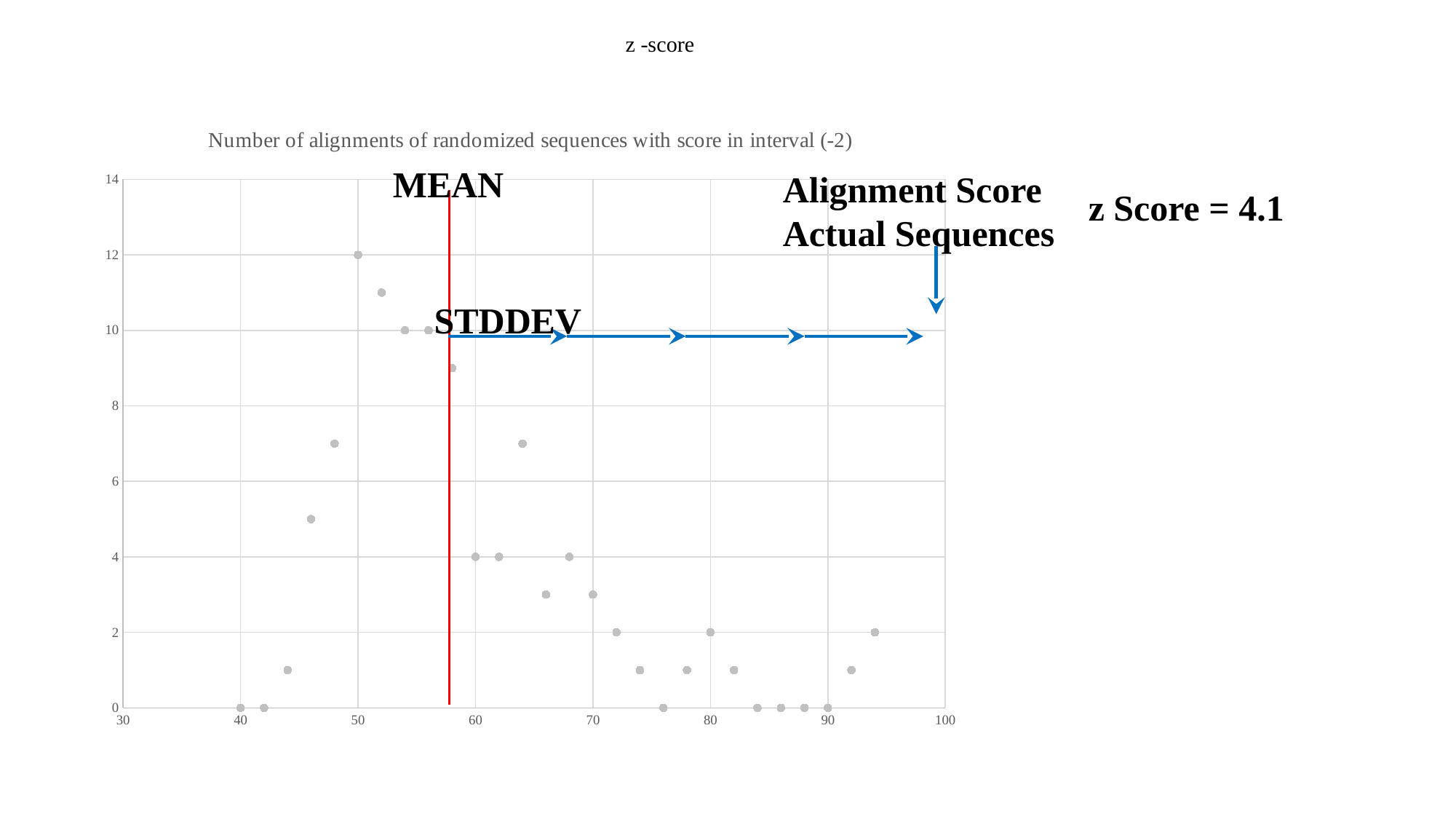
Which point has a larger y value, the one at x = 50 or the one at x = 80? x = 50 Is the y value of the point at x = 70 greater or less than 4? less What kind of chart is shown on the slide? scatter chart What is the y value of the point at x = 50? 12 What z Score is stated on the slide? 4.1 What is the highest y value plotted on the chart? 12 What is the y value of the point at x = 60? 4 What is the title of the chart? Number of alignments of randomized sequences with score in interval (-2) What is the difference between the y value at x = 50 and the y value at x = 60? 8 What is the y value of the point at x = 80? 2 What is the y value of the point at x = 90? 0 At which x value does the highest point on the chart occur? 50